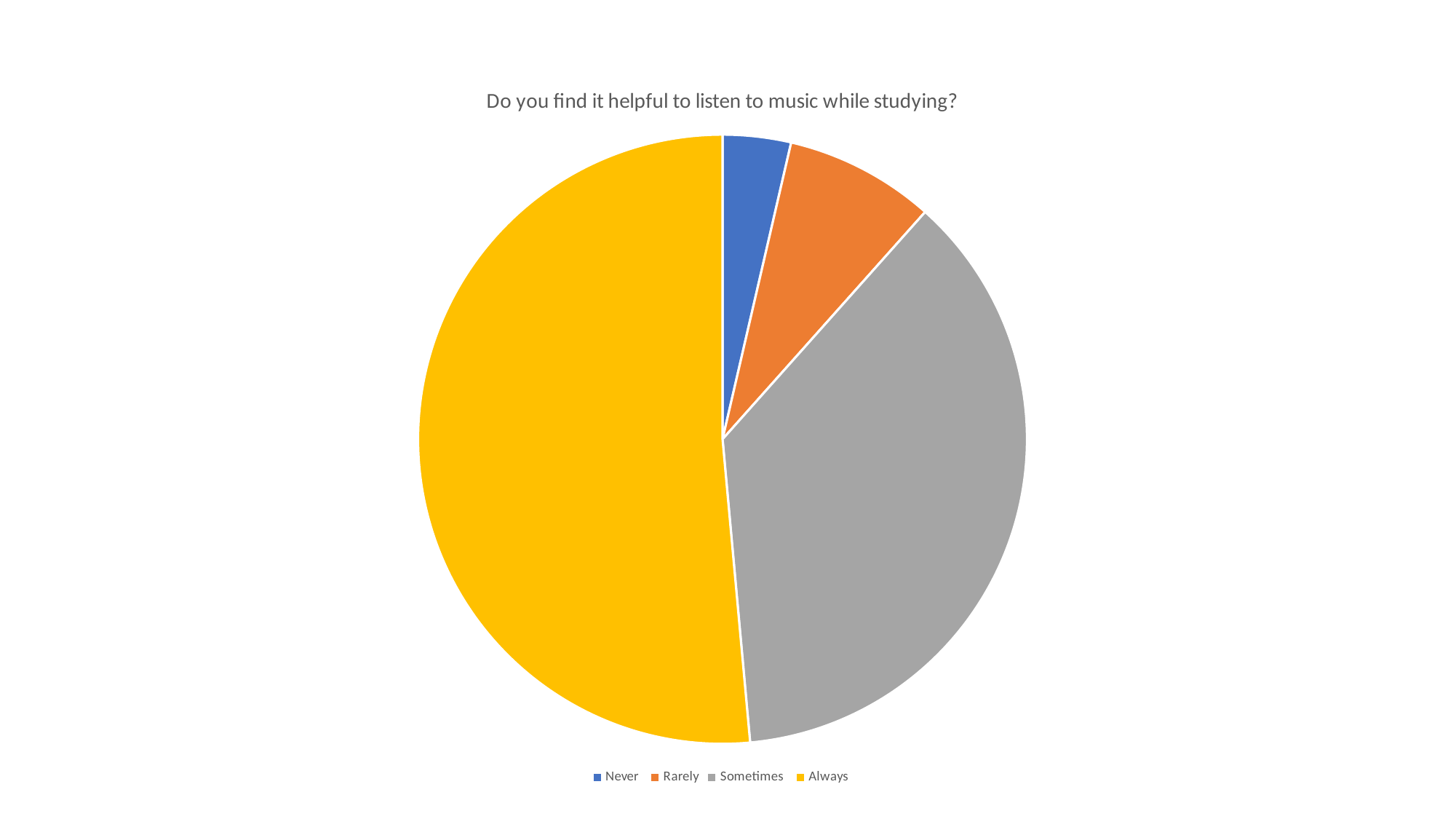
Which category is shown in yellow in the pie chart? Always Which category has the smallest slice of the pie? Never Which slice is larger, Always or Sometimes? Always How many slices does the pie chart have? 4 What kind of chart is shown on the slide? Pie chart What is the title of the chart? Do you find it helpful to listen to music while studying? Which category has the largest slice of the pie? Always Which category has the second-largest slice of the pie? Sometimes Which slice is larger, Sometimes or Rarely? Sometimes Which slice is larger, Rarely or Never? Rarely How many entries does the legend list? 4